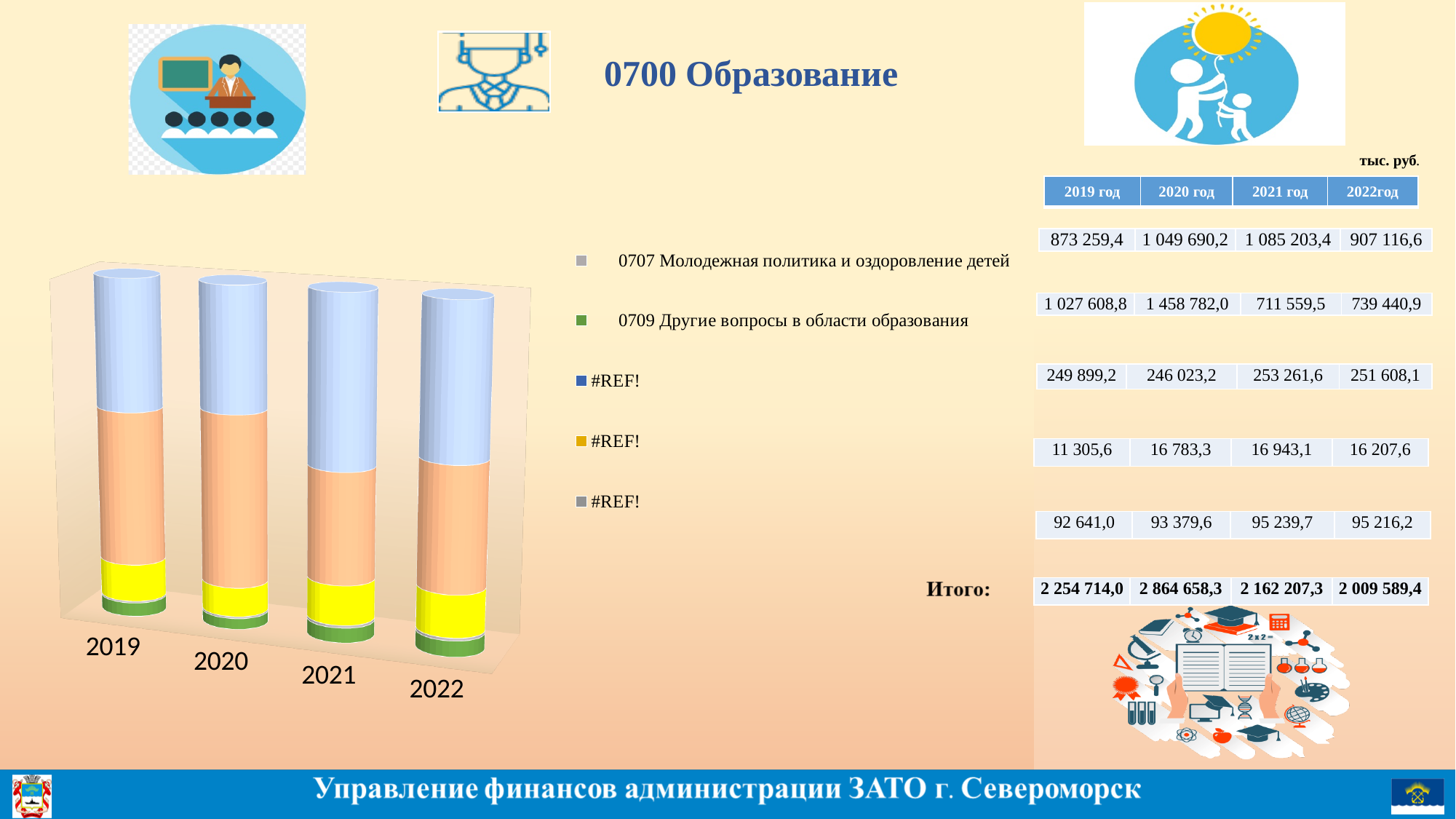
In the table, what is the Итого value for 2021 год? 2 162 207,3 How many years (categories) are shown along the bottom of the bar chart? 4 In the table, which year has the highest Итого value? 2020 год In the table, what is the difference between the Итого values for 2020 год and 2019 год? 609 944,3 How many series does the chart legend list? 5 Which years are shown as categories in the bar chart? 2019, 2020, 2021, 2022 What kind of chart is shown on the left of the slide? stacked bar chart In the table, what is the Итого value for 2022год? 2 009 589,4 In the table, which year has the lowest Итого value? 2022год In the table, what is the Итого value for 2019 год? 2 254 714,0 What is the first readable legend entry of the chart (the one with the grey marker at the top)? 0707 Молодежная политика и оздоровление детей In the table, what is the Итого value for 2020 год? 2 864 658,3